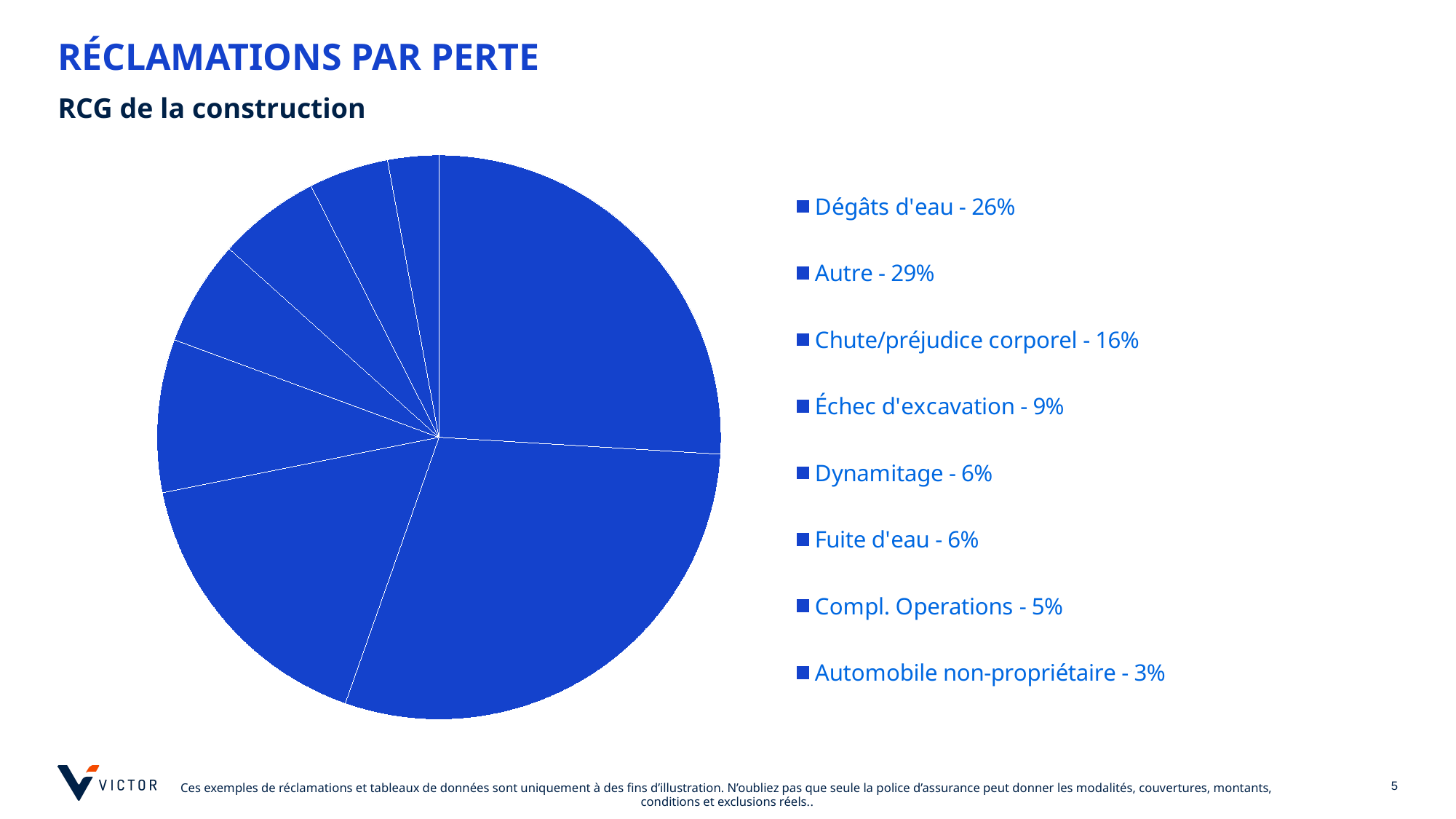
What is the difference in percentage points between Autre and Dégâts d'eau? 3 What percentage does the legend give for Chute/préjudice corporel? 16% What is the share for Échec d'excavation? 9% Which two categories share the same percentage of 6%? Dynamitage and Fuite d'eau How many categories does the legend list? 8 What is the subtitle shown above the chart? RCG de la construction Which category has the smallest share of the pie? Automobile non-propriétaire Which is larger, the share for Échec d'excavation or the share for Compl. Operations? Échec d'excavation Which category has the largest share of the pie? Autre What kind of chart is shown on the slide? pie chart What share of claims is attributed to Dégâts d'eau? 26% What percentage is shown for Automobile non-propriétaire? 3%